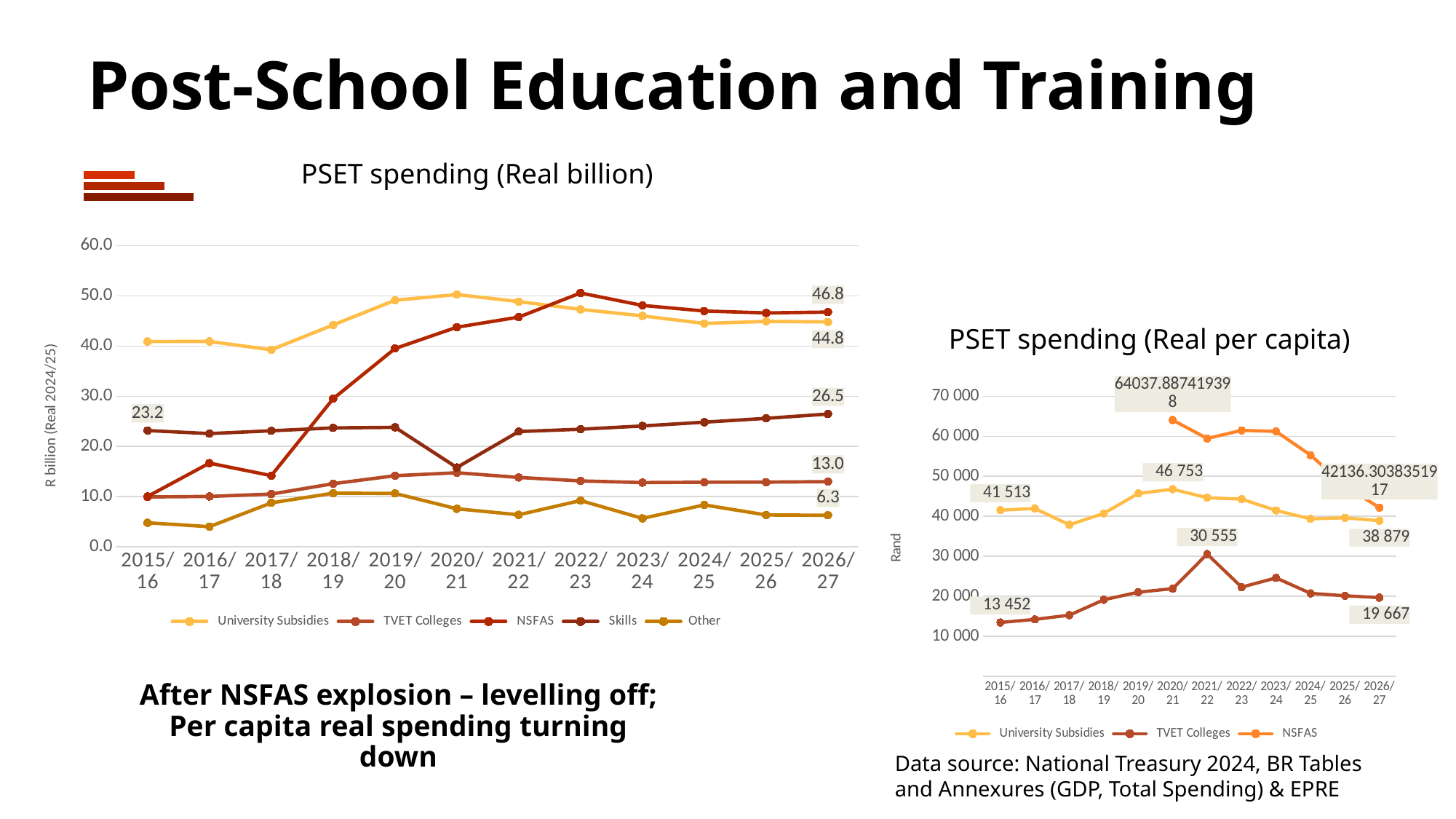
In the 'PSET spending (Real billion)' chart, what is the NSFAS value for 2026/27? 46.8 In the 'PSET spending (Real billion)' chart, which series has the highest value in 2026/27? NSFAS In the 'PSET spending (Real billion)' chart, what is the Skills value for 2015/16? 23.2 How many series does the legend of the 'PSET spending (Real per capita)' chart list? 3 In the 'PSET spending (Real billion)' chart, is the value for Other in 2015/16 greater or less than 10.0? less In the 'PSET spending (Real per capita)' chart, what is the difference between the University Subsidies values for 2015/16 and 2026/27? 2 634 In the 'PSET spending (Real per capita)' chart, what is the TVET Colleges value for 2021/22? 30 555 In the 'PSET spending (Real per capita)' chart, do University Subsidies rise or fall from 2020/21 to 2026/27? fall What kind of chart is the 'PSET spending (Real billion)' chart? line chart How many series does the legend of the 'PSET spending (Real billion)' chart list? 5 How many financial years are shown on the x axis of the 'PSET spending (Real billion)' chart? 12 In the 'PSET spending (Real billion)' chart, which series has the lowest value in 2026/27? Other